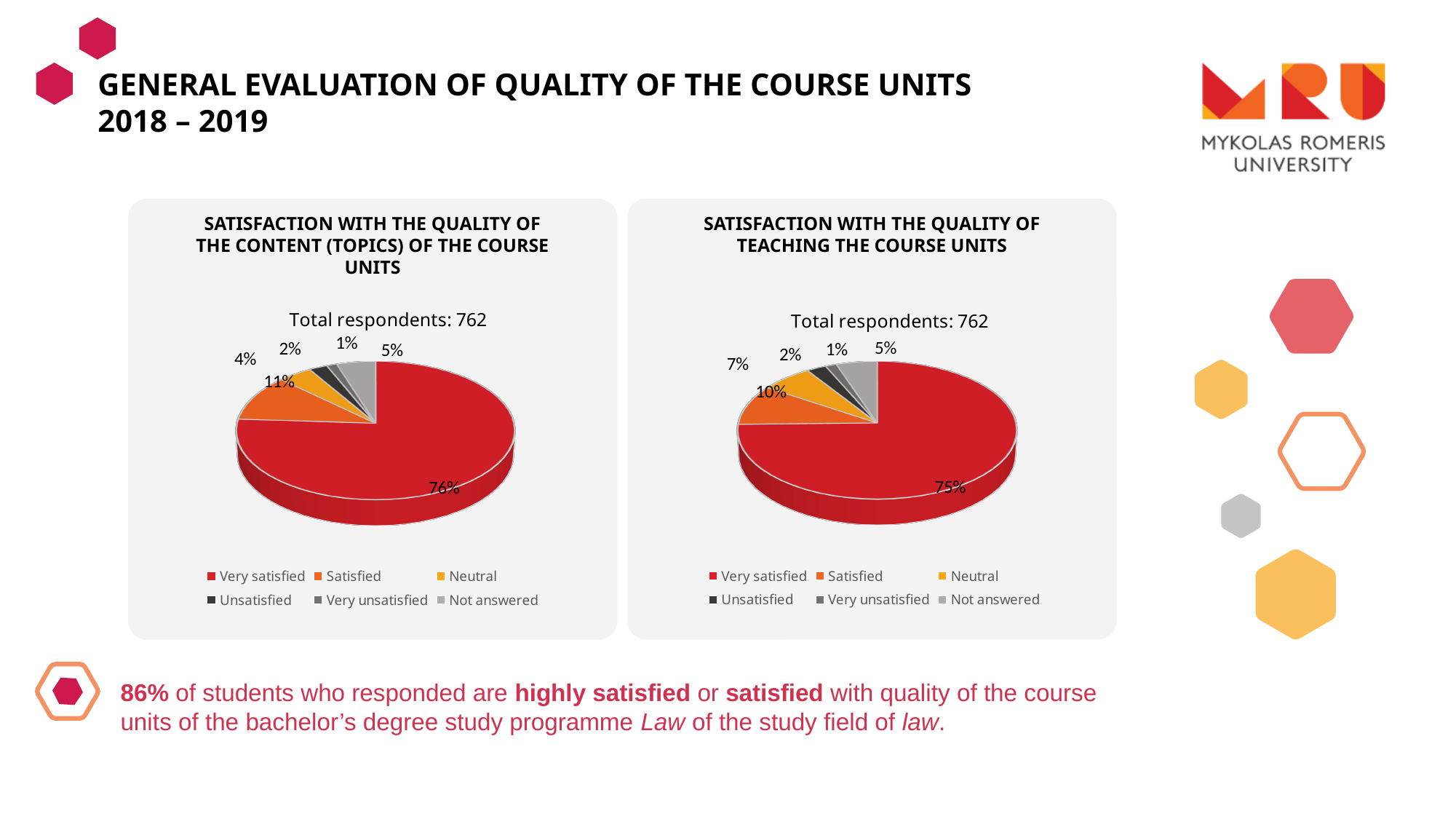
In the 'Satisfaction with the quality of the content (topics) of the course units' chart, which category has the smallest share? Very unsatisfied In the 'Satisfaction with the quality of the content (topics) of the course units' chart, what share of respondents were very satisfied? 76% How many categories does the legend of the 'Satisfaction with the quality of teaching the course units' chart list? 6 In the 'Satisfaction with the quality of teaching the course units' chart, what share of respondents did not answer? 5% In the 'Satisfaction with the quality of the content (topics) of the course units' chart, what share of respondents were satisfied? 11% In the 'Satisfaction with the quality of the content (topics) of the course units' chart, what is the difference between the very satisfied and satisfied shares? 65% In the 'Satisfaction with the quality of teaching the course units' chart, what share of respondents were very satisfied? 75% What kind of chart is used for 'Satisfaction with the quality of the content (topics) of the course units'? Pie chart How many total respondents are reported for the 'Satisfaction with the quality of the content (topics) of the course units' chart? 762 In the 'Satisfaction with the quality of teaching the course units' chart, which category has the largest share? Very satisfied In the 'Satisfaction with the quality of teaching the course units' chart, what share of respondents were neutral? 7% Which chart shows a larger share of very satisfied respondents, the content (topics) chart or the teaching chart? The content (topics) chart